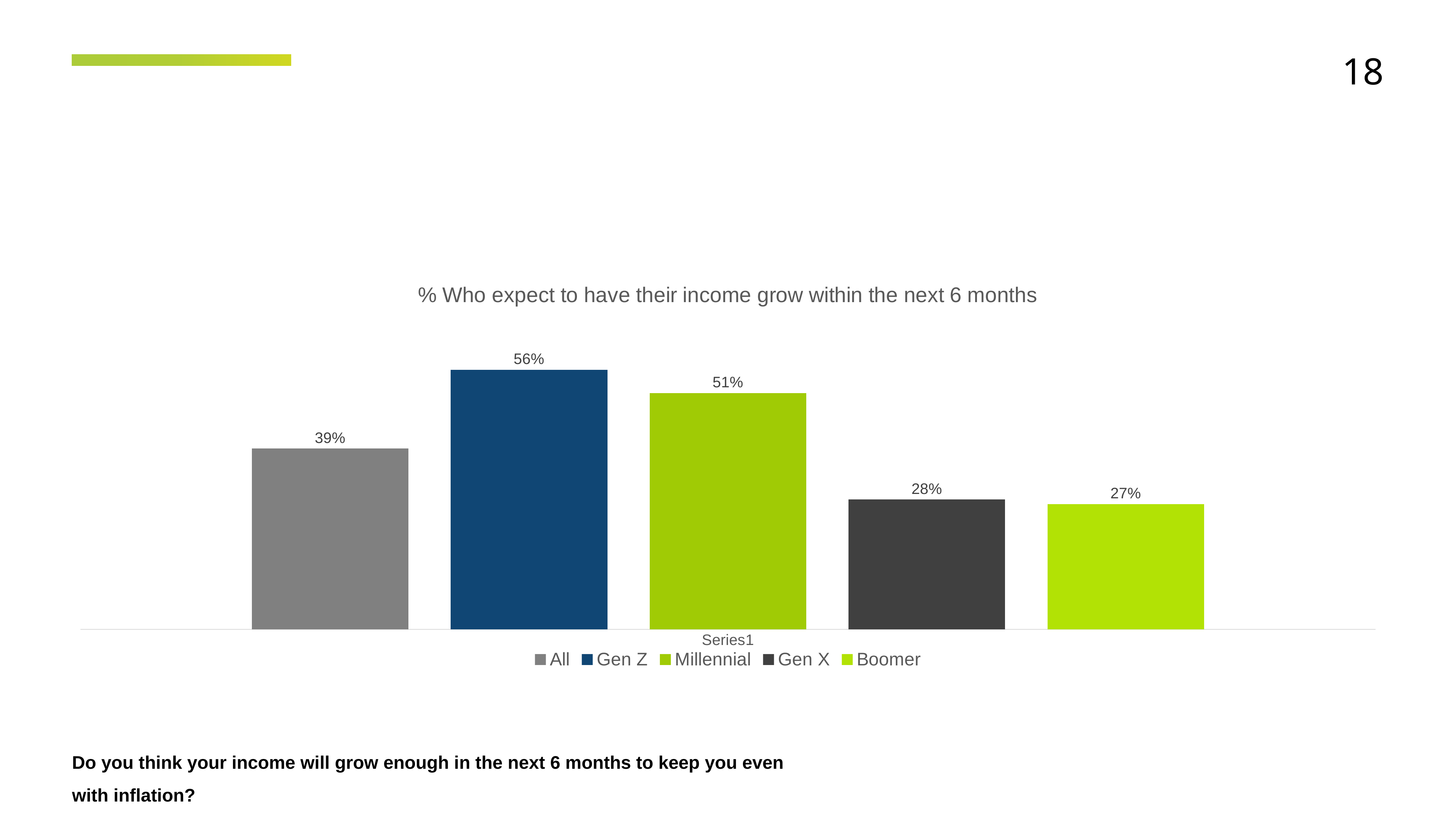
Which group has the lowest value? Boomer What is the title of the chart? % Who expect to have their income grow within the next 6 months What is the difference between the values for Millennial and Gen X? 23% What is the difference between the values for Gen Z and Millennial? 5% How many series does the legend list? 5 What is the value for Gen X? 28% Which group has the highest value? Gen Z What kind of chart is shown on the slide? Bar chart What is the value for All? 39% Which is larger, the value for All or the value for Millennial? Millennial What is the value for Boomer? 27% What is the value for Gen Z? 56%